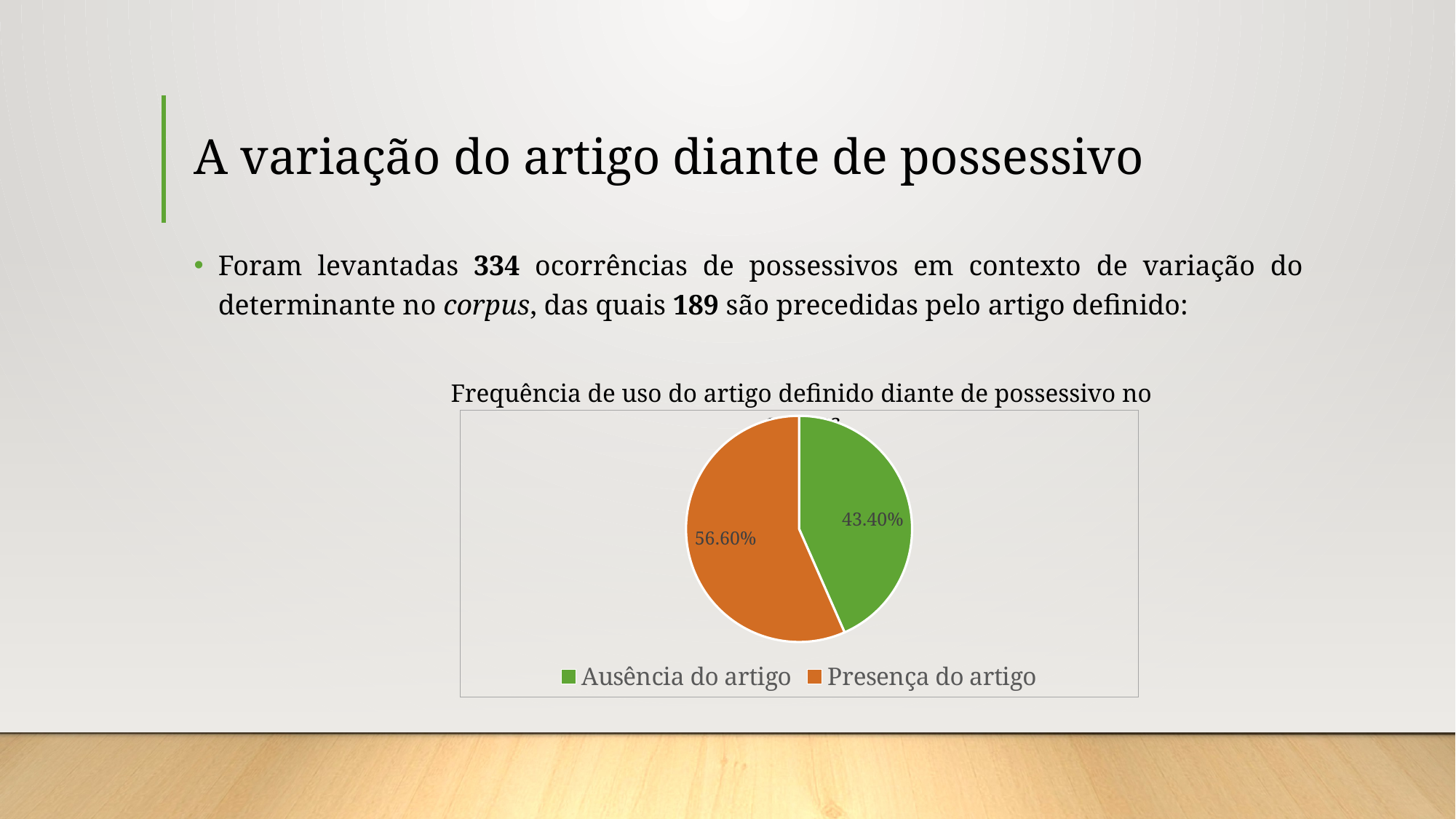
What kind of chart is shown on the slide? pie chart Which slice of the pie is the largest? Presença do artigo What is the difference in percentage points between "Presença do artigo" and "Ausência do artigo"? 13.20% What colour is the slice for "Ausência do artigo"? green What share of the pie does "Presença do artigo" represent? 56.60% What share of the pie does "Ausência do artigo" represent? 43.40% How many slices does the pie chart have? 2 How many entries does the legend list? 2 Which slice of the pie is the smallest? Ausência do artigo What colour is the slice for "Presença do artigo"? orange Which is larger, the share for "Ausência do artigo" or the share for "Presença do artigo"? Presença do artigo